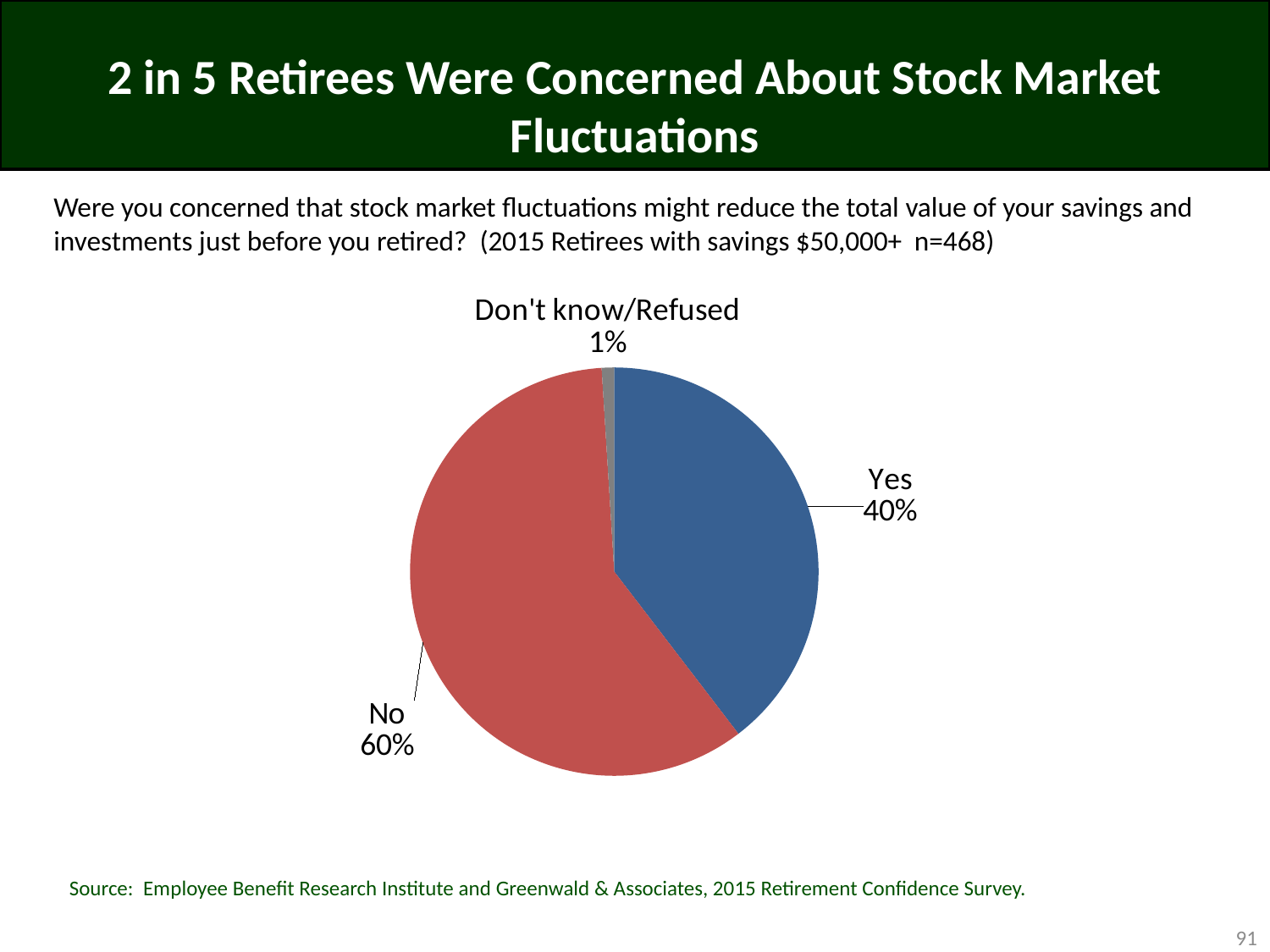
Which response has the smallest share of the pie? Don't know/Refused Which slice is larger, "Yes" or "No"? No What share of the pie does the "Yes" slice represent? 40% What kind of chart is shown on the slide? Pie chart How many slices does the pie chart have? 3 What percentage of retirees answered "No"? 60% What percentage of retirees answered "Don't know/Refused"? 1% What percentage of retirees answered "Yes"? 40% What colour is the "No" slice? Red What is the difference in percentage points between the "No" and "Yes" slices? 20 What is the sample size (n) stated in the question text above the chart? 468 Which response has the largest share of the pie? No